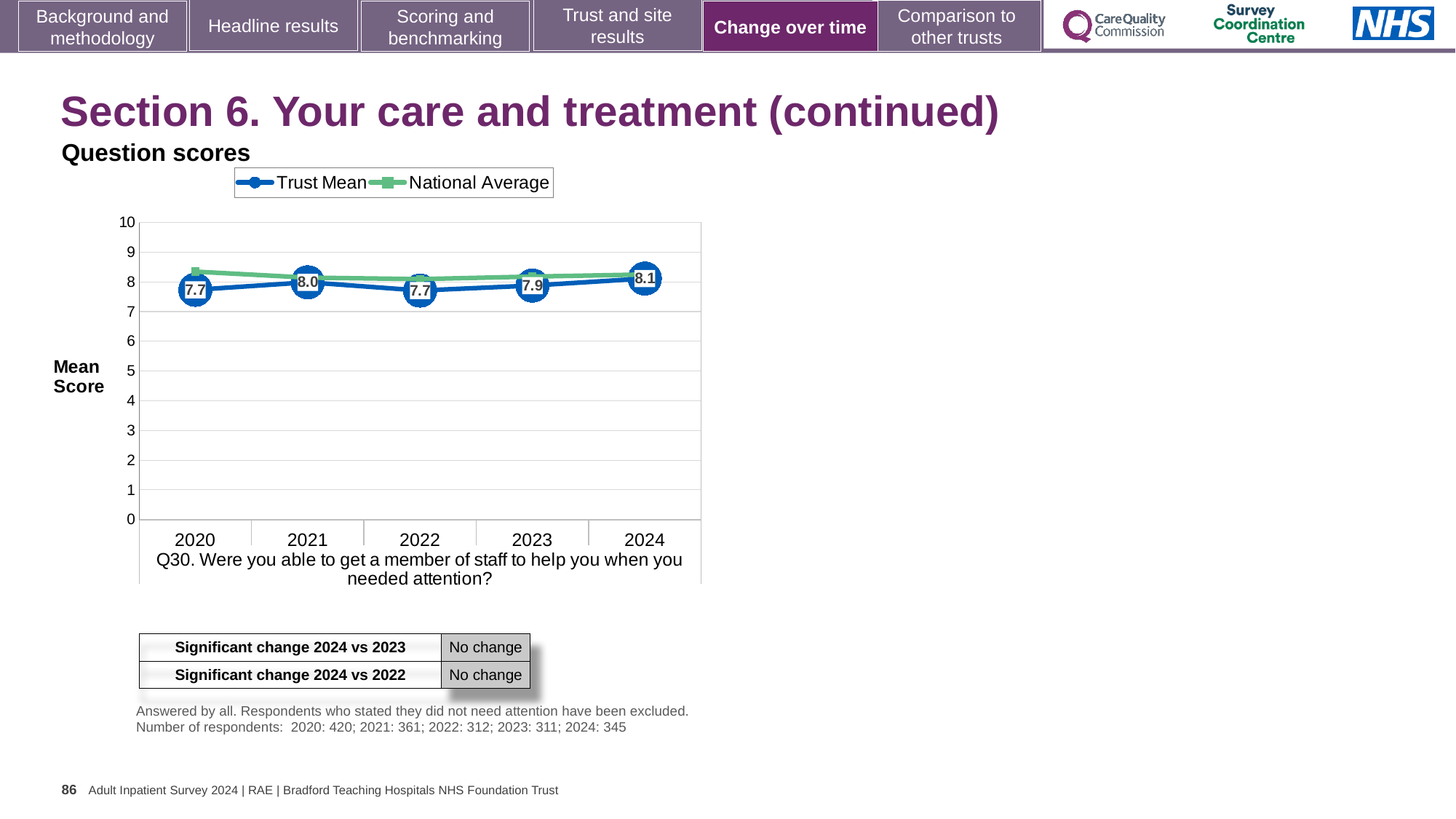
Which question does the chart relate to? Q30. Were you able to get a member of staff to help you when you needed attention? In which year is the Trust Mean score highest? 2024 How many series does the legend list? 2 What kind of chart is shown on the slide? line chart What is the Trust Mean score for 2021? 8.0 Is the National Average value for 2020 greater or less than 8? greater What is the Trust Mean score for 2024? 8.1 What is the Trust Mean score for 2020? 7.7 How many years are shown on the x axis? 5 What is the difference between the Trust Mean scores for 2024 and 2022? 0.4 Which is larger, the Trust Mean score for 2021 or for 2022? 2021 What is the Trust Mean score for 2023? 7.9